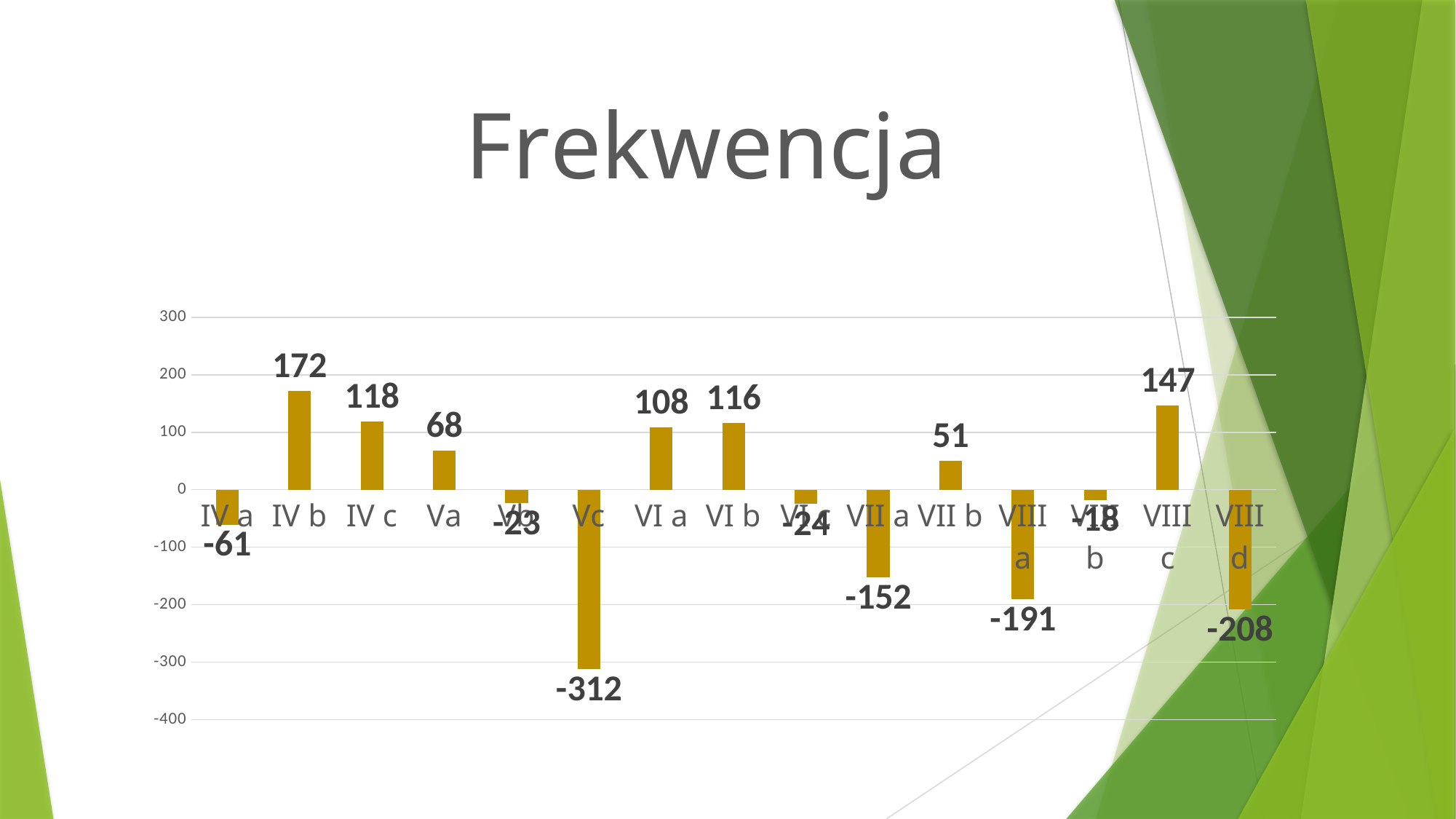
What is the value for Vc? -312 What is the value for VIII c? 147 What is the title of the slide? Frekwencja Which category has the highest value? IV b Which category has the lowest value? Vc What is the value for IV b? 172 How many categories are shown on the x axis? 15 What is the value for VII a? -152 Which is larger, the value for VI a or the value for VI b? VI b What is the difference between the values for VIII d and VIII a? 17 What is the difference between the values for IV b and IV c? 54 What kind of chart is shown on the slide? bar chart